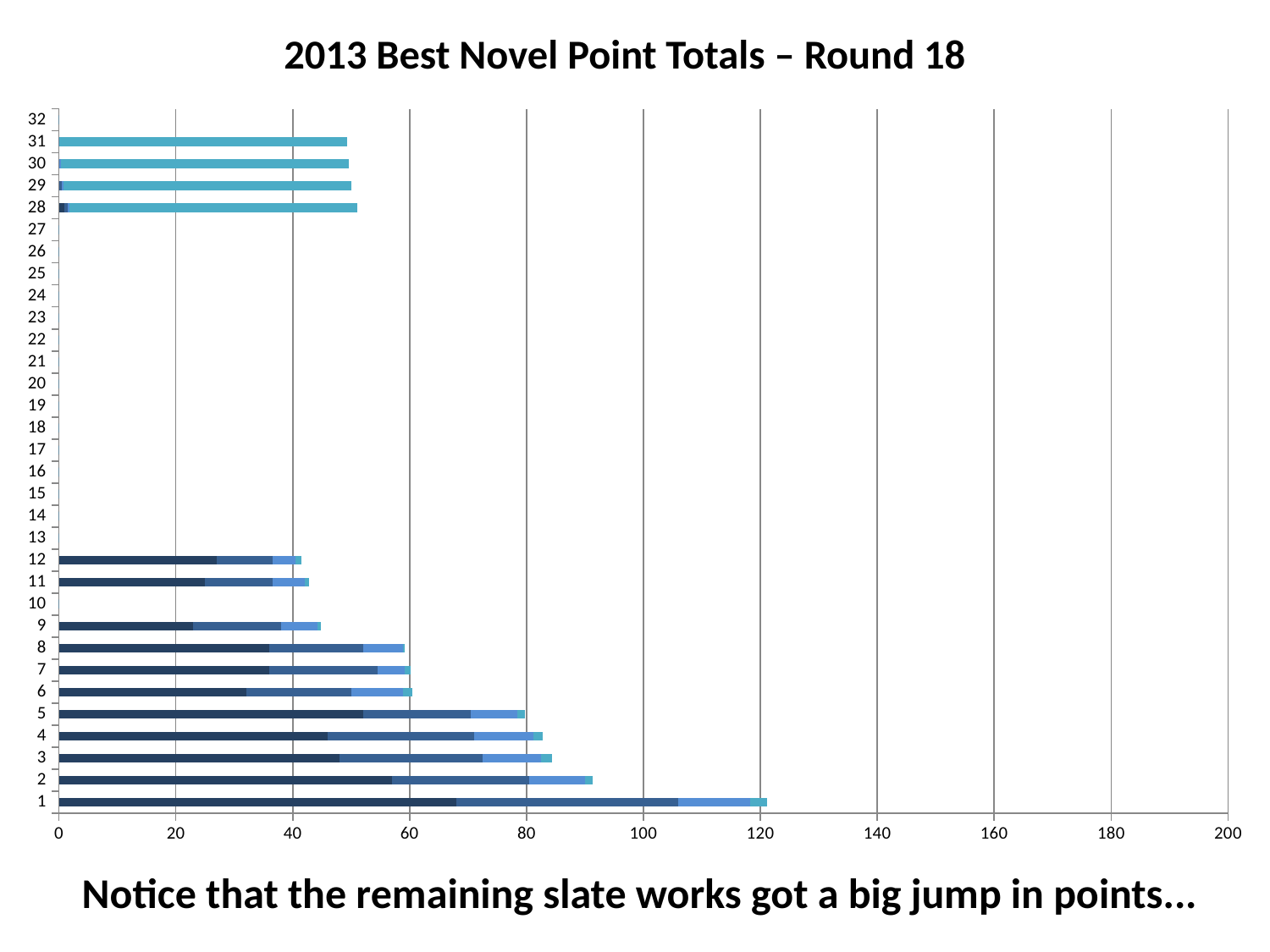
What kind of chart is shown on the slide? bar chart How many category labels are listed on the vertical axis? 32 Is the value for category 1 greater or less than 100? greater What is the title of the chart? 2013 Best Novel Point Totals – Round 18 Is the value for category 9 greater or less than 40? greater Which has the larger total, category 5 or category 6? 5 Which category has the longest bar in the chart? 1 Is the value for category 5 greater or less than 60? greater How many categories have a visible bar in the chart? 15 Which has the larger total, category 1 or category 2? 1